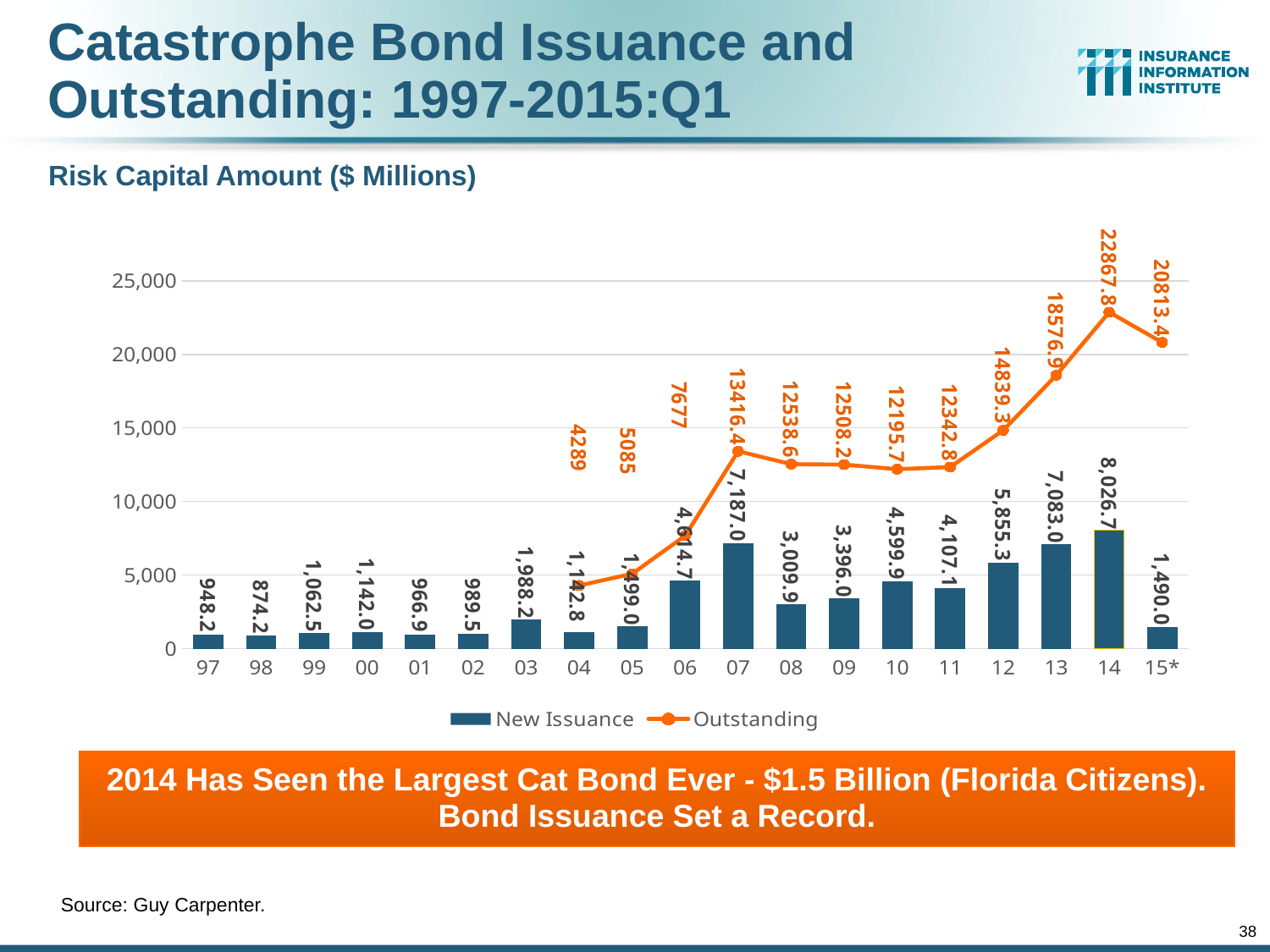
What is the New Issuance value for 15*? 1,490.0 How many years are shown on the x axis? 19 How many series does the legend list? 2 What is the Outstanding value for 2014 (14)? 22867.8 Which year has the larger New Issuance value, 07 or 13? 07 What is the difference between the Outstanding values for 14 and 15*? 2054.4 What is the difference between the New Issuance values for 13 and 12? 1,227.7 Which year has the highest New Issuance value? 14 What is the New Issuance value for 2014 (14)? 8,026.7 What is the Outstanding value for 2004 (04)? 4289 Is the Outstanding value for 13 greater or less than 15,000? greater Which year has the lowest New Issuance value? 98